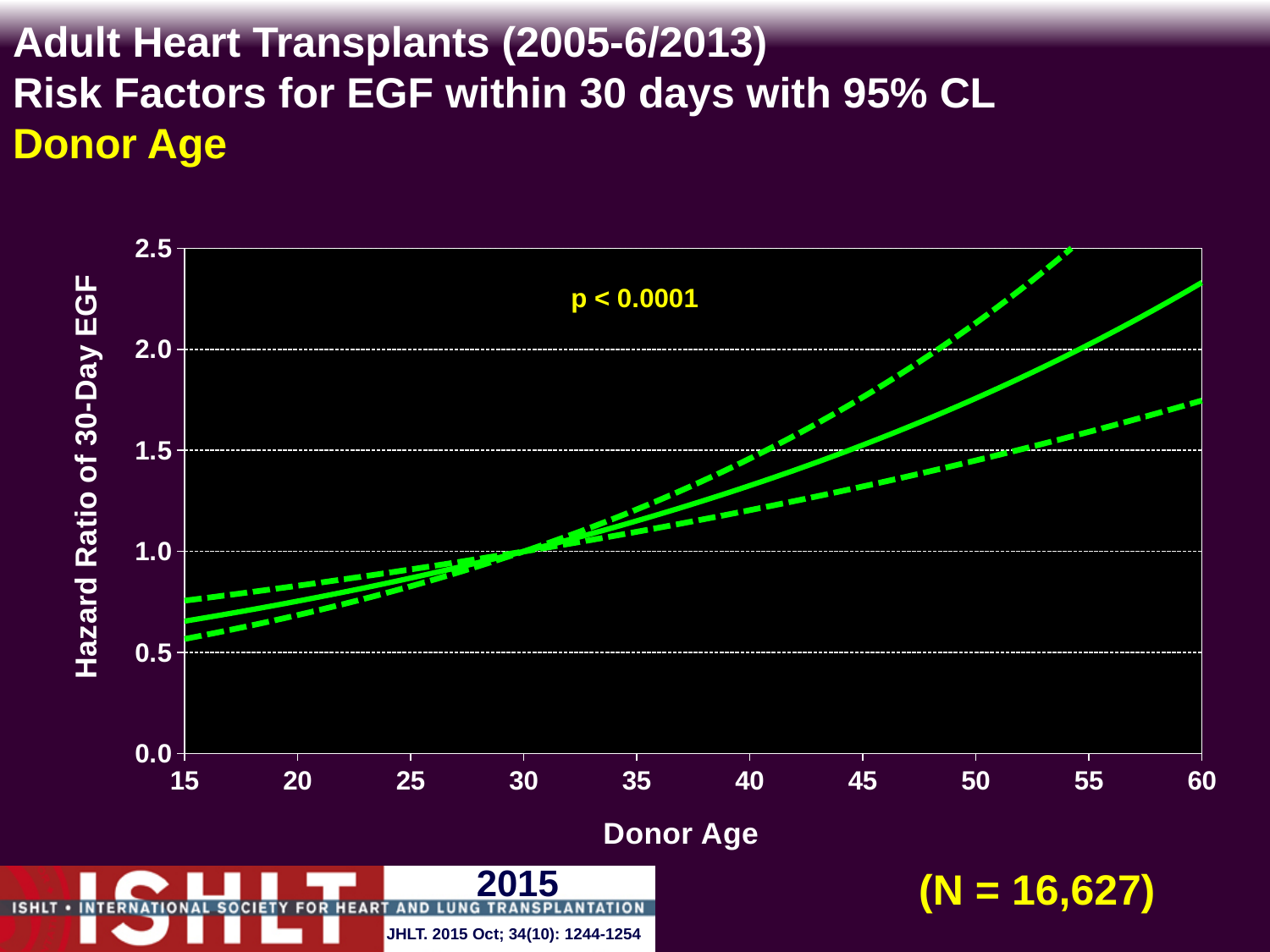
How many lines are plotted on the chart? 3 Is the hazard ratio (solid line) at donor age 15 greater or less than 1.0? less Is the lower dashed confidence limit at donor age 60 greater or less than 1.5? greater Is the hazard ratio (solid line) at donor age 60 greater or less than 2.0? greater Does the hazard ratio of 30-day EGF rise or fall as donor age increases from 15 to 60? rise What is the label of the x axis? Donor Age What kind of chart is shown on the slide? line chart What p-value is printed on the chart? p < 0.0001